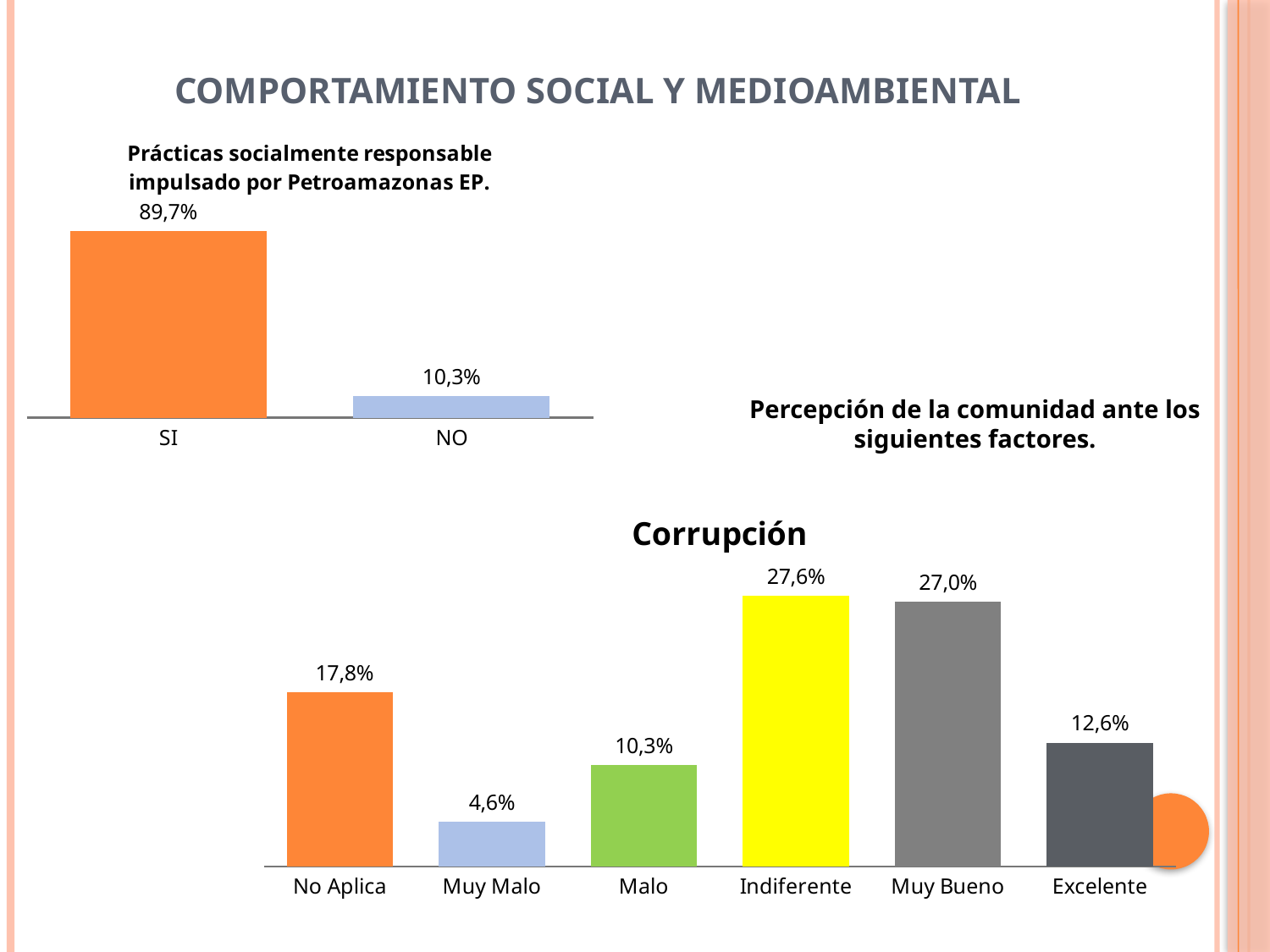
In the 'Corrupción' chart, which category has the lowest value? Muy Malo In the 'Corrupción' chart, which is larger, the value for No Aplica or the value for Excelente? No Aplica In the 'Corrupción' chart, which category has the highest value? Indiferente In the 'Corrupción' chart, how many categories are shown on the x axis? 6 In the 'Prácticas socialmente responsable impulsado por Petroamazonas EP.' chart, how many categories are shown? 2 In the 'Corrupción' chart, what is the value for Muy Malo? 4,6% In the 'Corrupción' chart, what is the value for Excelente? 12,6% In the 'Prácticas socialmente responsable impulsado por Petroamazonas EP.' chart, what is the difference between the SI and NO values? 79,4% In the 'Prácticas socialmente responsable impulsado por Petroamazonas EP.' chart, what is the value for SI? 89,7% In the 'Corrupción' chart, what is the difference between the No Aplica and Malo values? 7,5% In the 'Prácticas socialmente responsable impulsado por Petroamazonas EP.' chart, what is the value for NO? 10,3% In the 'Corrupción' chart, what is the value for Indiferente? 27,6%